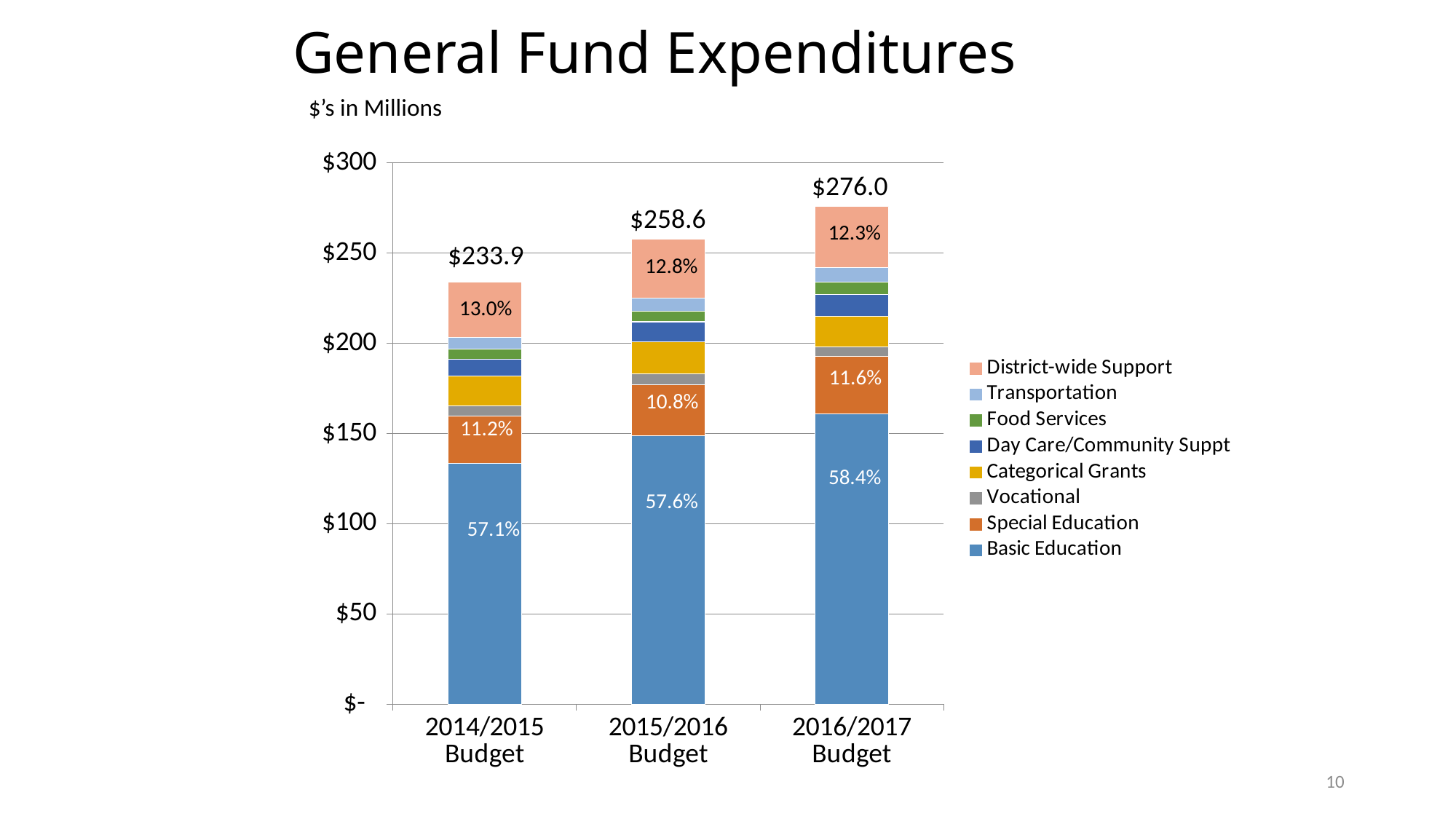
What is the difference between the total for the 2016/2017 Budget and the total for the 2014/2015 Budget? $42.1 What is the total General Fund Expenditures value shown for the 2014/2015 Budget? $233.9 What percentage is shown for District-wide Support in the 2015/2016 Budget bar? 12.8% Which budget year has the lowest total expenditures? 2014/2015 Budget How many budget years are shown on the x axis? 3 Is the Basic Education segment of the 2016/2017 Budget bar greater or less than $150? greater What percentage is shown for Special Education in the 2014/2015 Budget bar? 11.2% How many series does the legend list? 8 Do the total expenditures rise or fall from the 2014/2015 Budget to the 2016/2017 Budget? rise What percentage of the 2016/2017 Budget bar is labelled for Basic Education? 58.4% Which budget year has the highest total expenditures? 2016/2017 Budget Which budget year has the larger Basic Education percentage, 2015/2016 or 2016/2017? 2016/2017 Budget